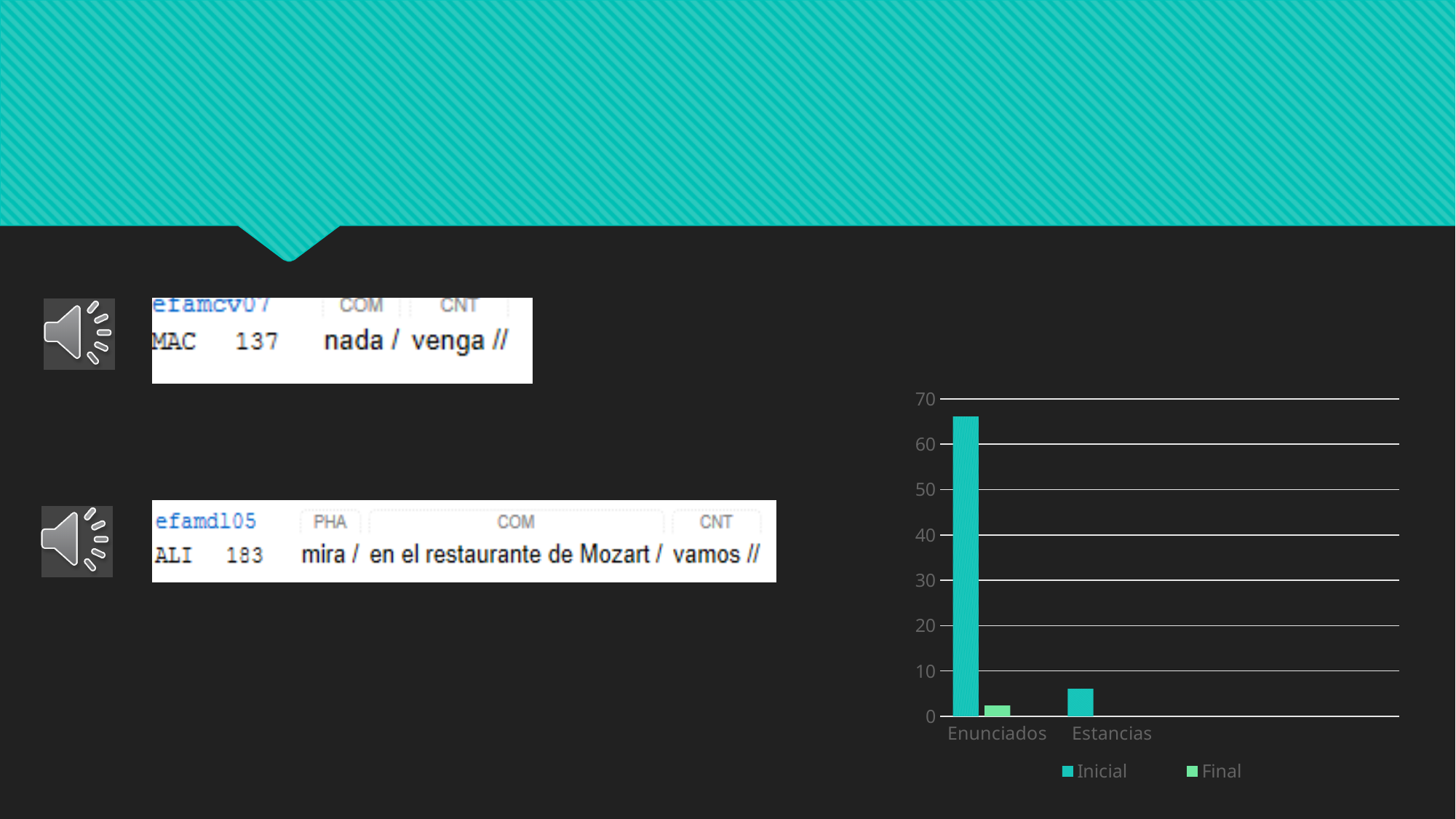
Is the Inicial value for Estancias greater or less than 10? less How many series does the chart's legend list? 2 Which is larger: the Inicial value for Enunciados or the Inicial value for Estancias? Enunciados Is the Final value for Enunciados greater or less than 10? less Is the Inicial value for Enunciados greater or less than 60? greater What kind of chart is shown on the slide? bar chart Which category has the lowest Inicial value in the chart? Estancias How many categories are shown on the x axis of the chart? 2 Which category has the highest Inicial value in the chart? Enunciados What is the highest value shown on the chart's vertical axis? 70 What are the two series named in the chart's legend? Inicial and Final Which is larger for Enunciados: the Inicial value or the Final value? Inicial